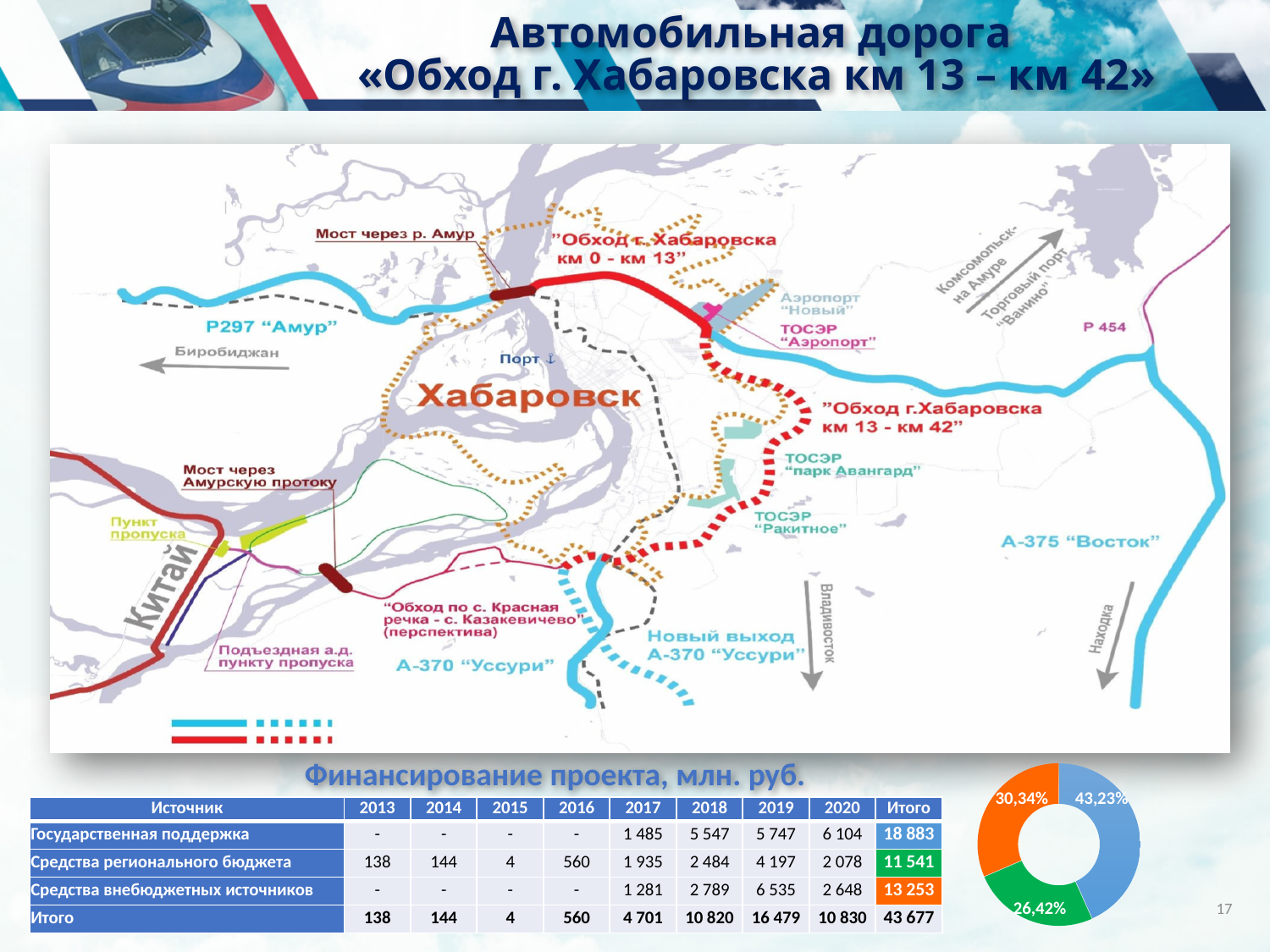
In the pie chart at the bottom right, what is the value of the smallest slice? 26,42% In the pie chart at the bottom right, what percentage is shown on the blue slice? 43,23% How many slices does the pie chart at the bottom right of the slide have? 3 In the pie chart at the bottom right, what is the difference in percentage points between the blue slice and the orange slice? 12,89% In the pie chart at the bottom right, what is the difference in percentage points between the blue slice and the green slice? 16,81% In the pie chart at the bottom right, which slice is larger, the orange one or the green one? orange What kind of chart is shown at the bottom right of the slide? doughnut chart In the pie chart at the bottom right, what percentage is shown on the orange slice? 30,34% In the pie chart at the bottom right, what colour is the largest slice? blue In the pie chart at the bottom right, which slice is larger, the blue one or the orange one? blue In the pie chart at the bottom right, what percentage is shown on the green slice? 26,42% In the pie chart at the bottom right, what is the value of the largest slice? 43,23%